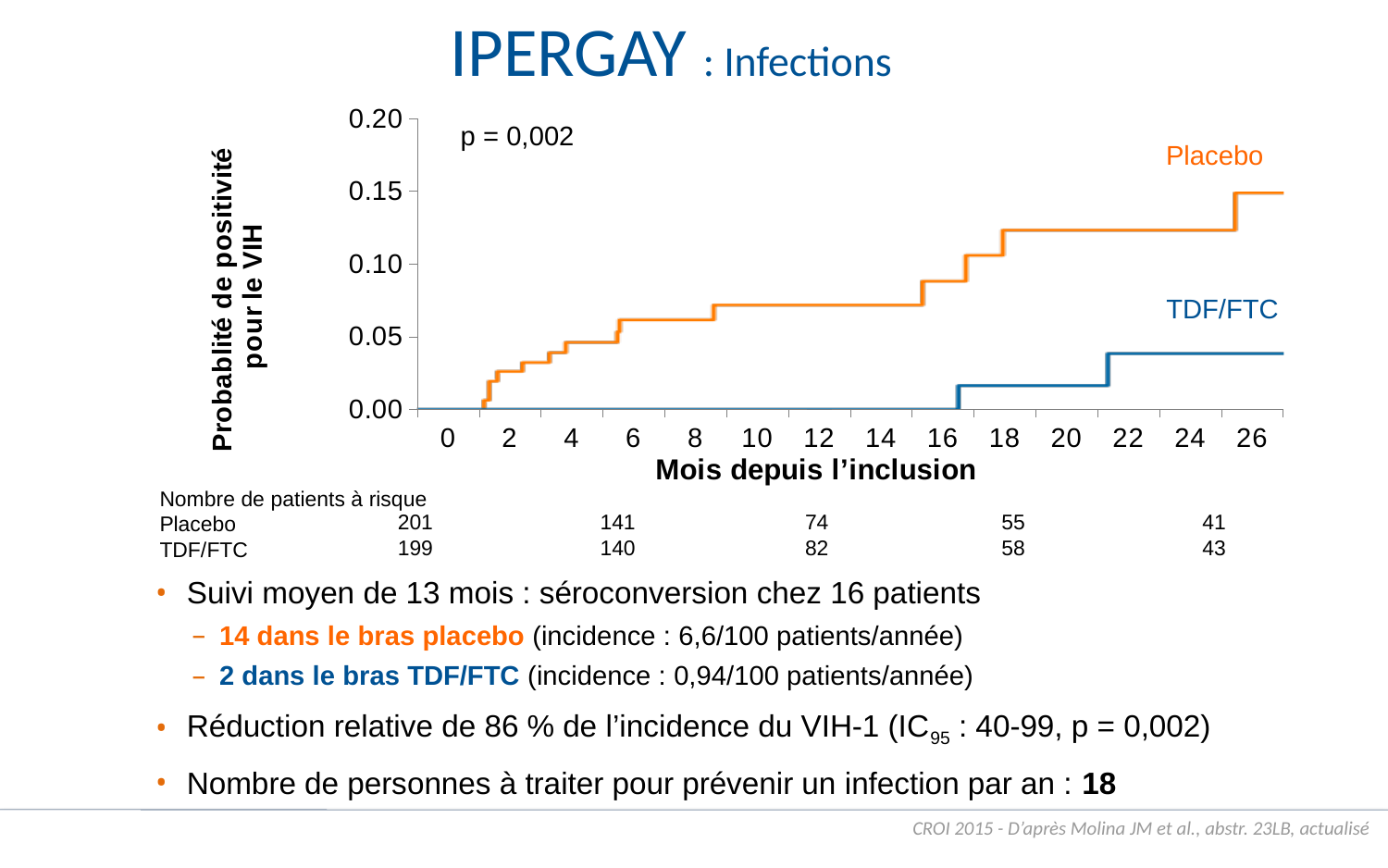
How many patients at risk are listed for the TDF/FTC group at month 0? 199 What is the last number of patients at risk listed for the TDF/FTC group? 43 What is the difference between the Placebo and TDF/FTC numbers of patients at risk in the third column (74 vs 82)? 8 What kind of chart is shown on the slide? line chart Which curve is higher at the end of follow-up (month 26), Placebo or TDF/FTC? Placebo Do the curves rise or fall as months since inclusion increase? rise Is the TDF/FTC probability at month 26 greater or less than 0.05? less How many series (curves) are plotted on the chart? 2 Is the Placebo probability at month 26 greater or less than 0.10? greater What is the label of the x axis? Mois depuis l'inclusion What is the p-value printed on the chart? p = 0,002 How many patients at risk are listed for the Placebo group at month 0? 201